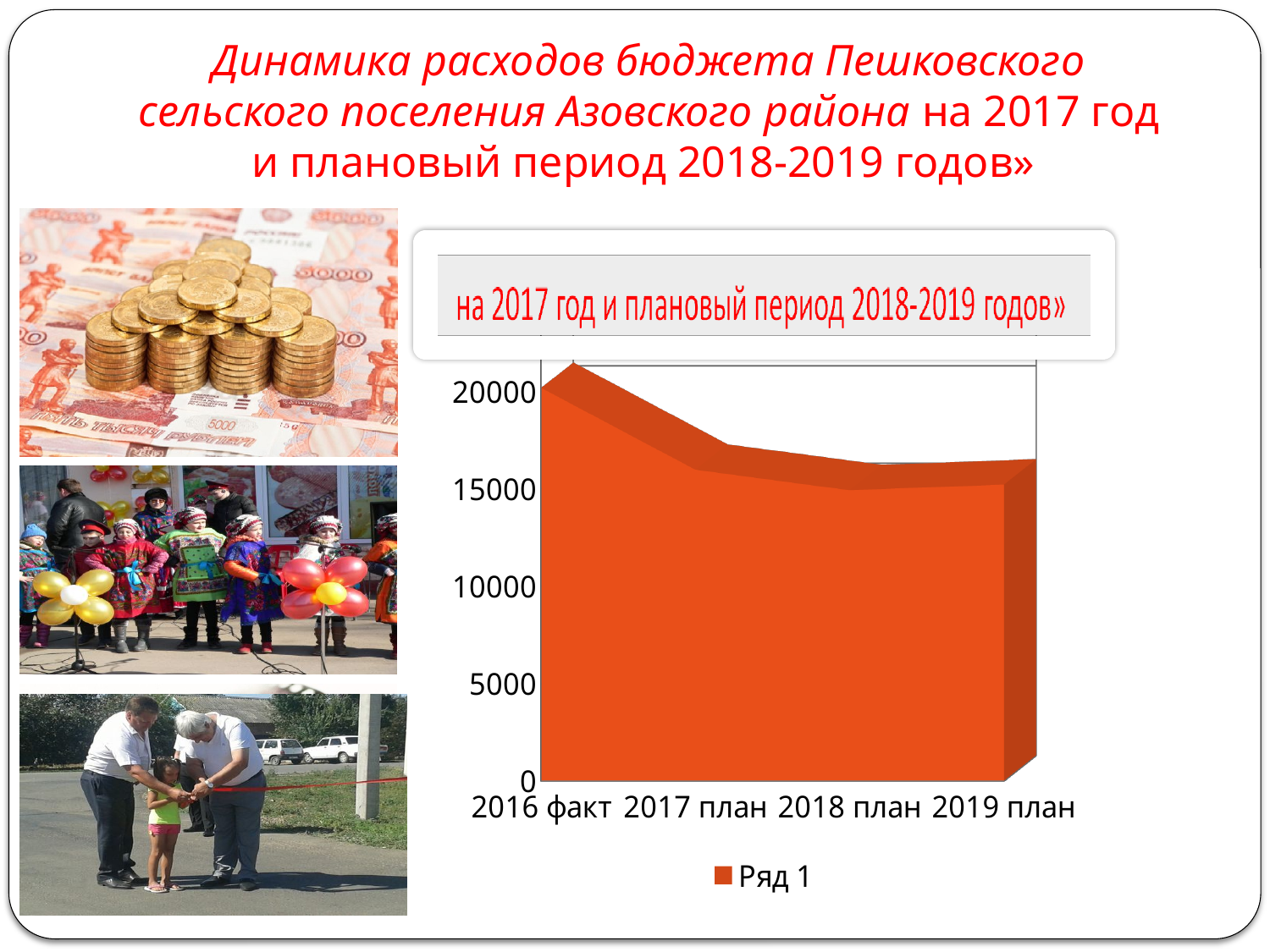
Is the value for 2017 план greater or less than 20000? less Which category has the highest value in the chart? 2016 факт Is the value for 2016 факт greater or less than 15000? greater What is the name of the series shown in the chart legend? Ряд 1 What is the first category label on the x axis of the chart? 2016 факт Is the value for 2018 план greater or less than 10000? greater How many categories are shown along the x axis of the chart? 4 Do the values generally rise or fall from 2016 факт to 2019 план? fall How many series does the chart legend list? 1 What kind of chart is shown on the slide? area chart Which is larger, the value for 2016 факт or the value for 2017 план? 2016 факт